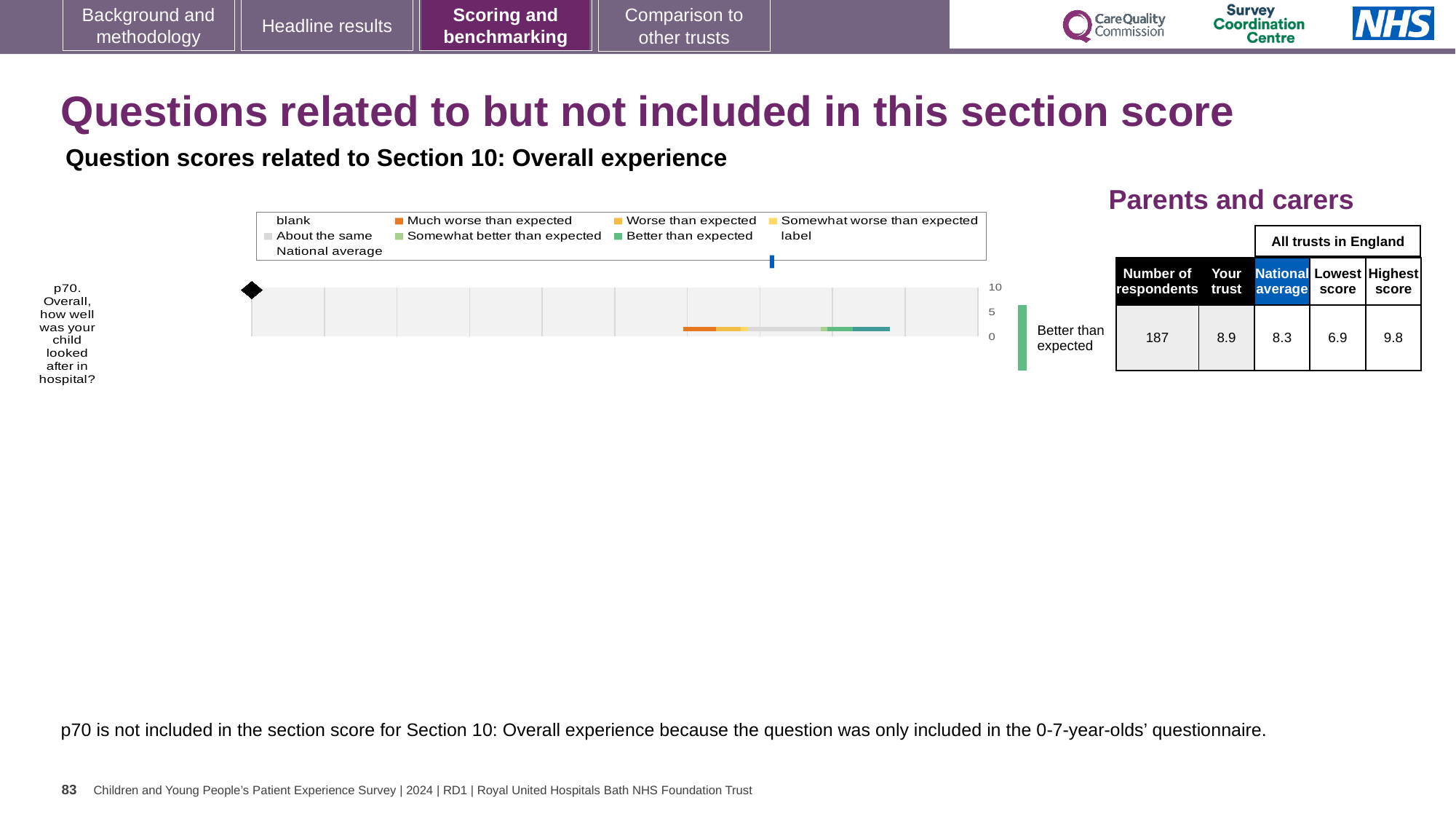
Which is higher for p70: the trust's score or the national average? Your trust What is the highest score among all trusts in England for p70? 9.8 What is the lowest score among all trusts in England for p70? 6.9 What is the difference between the trust's score and the national average for p70? 0.6 What is the national average score for p70? 8.3 What is the difference between the highest and lowest scores across all trusts in England for p70? 2.9 How many respondents answered p70? 187 How many questions are plotted in the chart? 1 What is the 'Your trust' score for p70 in the table? 8.9 Which respondent group does the table refer to? Parents and carers What benchmark category is shown next to the p70 bar? Better than expected What kind of chart is shown for question p70? bar chart